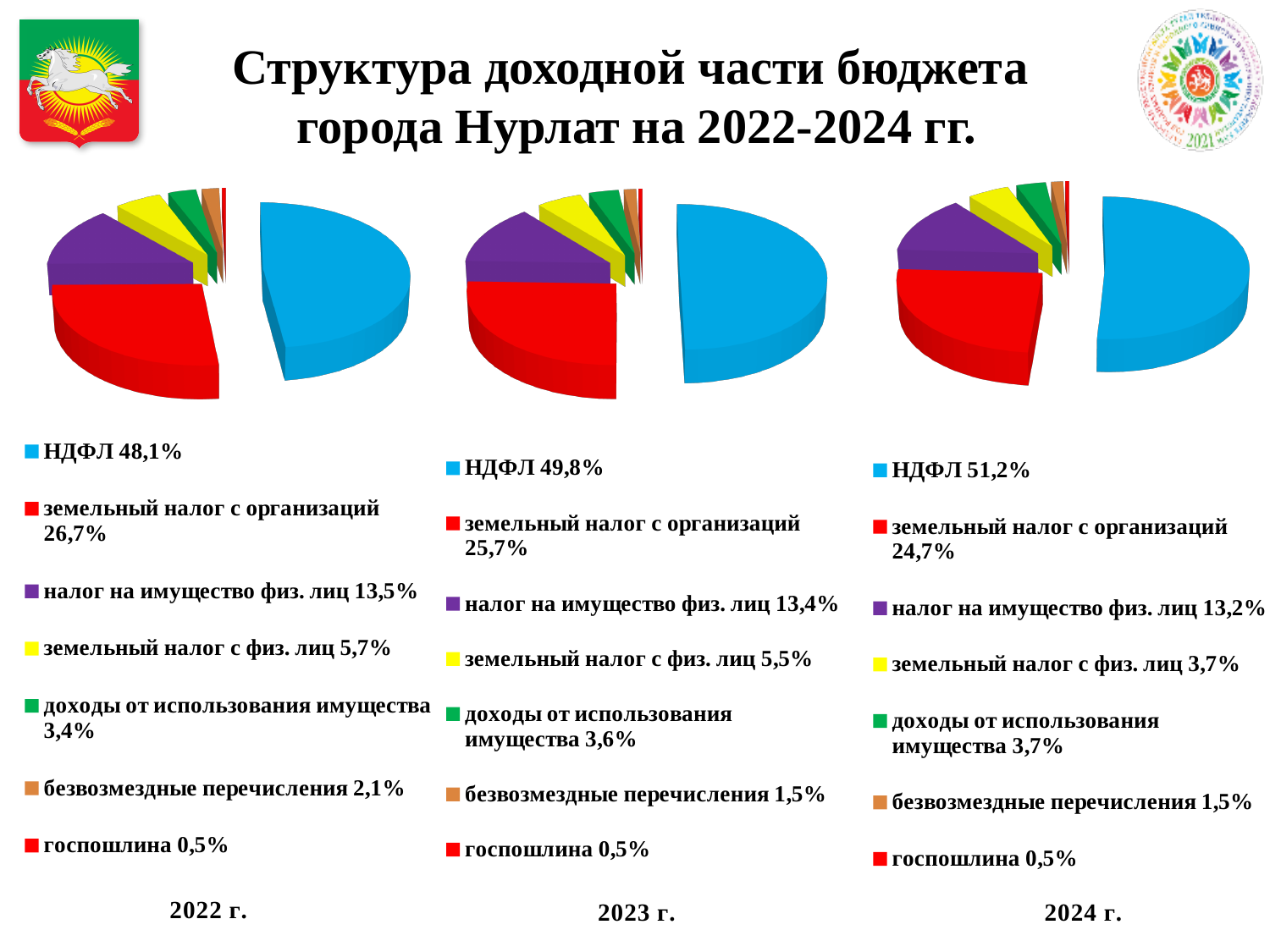
What type of chart is used on this slide for each year? Pie chart In the 2022 pie chart, what share does НДФЛ have? 48,1% What colour represents НДФЛ in the pie charts? Blue Which is larger: безвозмездные перечисления in 2022 or in 2023? 2022 In the 2022 pie chart, which category has the smallest share? госпошлина In the 2023 pie chart, what is the value for земельный налог с организаций? 25,7% In the 2024 pie chart, what is the value for земельный налог с физ. лиц? 3,7% What is the difference between the НДФЛ share in 2024 and in 2022? 3,1% How many categories does the legend of the 2023 pie chart list? 7 In the 2024 pie chart, which category has the largest share? НДФЛ In the 2023 pie chart, what is the value for налог на имущество физ. лиц? 13,4% How many pie charts are shown on the slide? 3